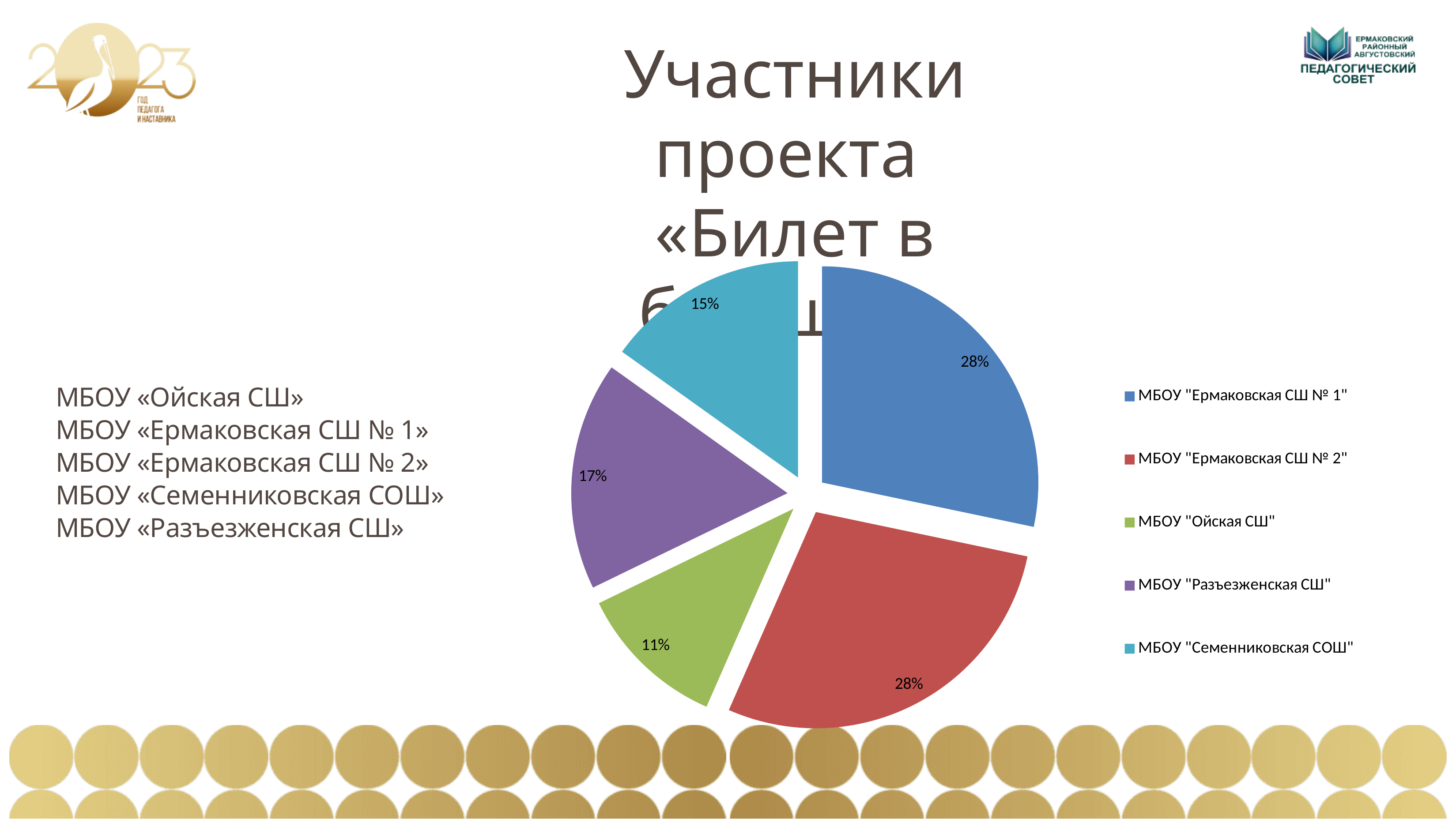
What kind of chart is shown on the slide? pie chart What share of the pie does МБОУ "Ермаковская СШ № 1" have? 28% What share of the pie does МБОУ "Ойская СШ" have? 11% What colour is the slice for МБОУ "Ойская СШ"? green Which school has the smallest slice of the pie? МБОУ "Ойская СШ" Which slice is larger: МБОУ "Разъезженская СШ" or МБОУ "Семенниковская СОШ"? МБОУ "Разъезженская СШ" What share of the pie does МБОУ "Семенниковская СОШ" have? 15% What share of the pie does МБОУ "Разъезженская СШ" have? 17% What share of the pie does МБОУ "Ермаковская СШ № 2" have? 28% How many slices does the pie chart have? 5 What is the difference in percentage points between the slices for МБОУ "Ермаковская СШ № 1" and МБОУ "Ойская СШ"? 17 What is the difference in percentage points between the slices for МБОУ "Разъезженская СШ" and МБОУ "Семенниковская СОШ"? 2